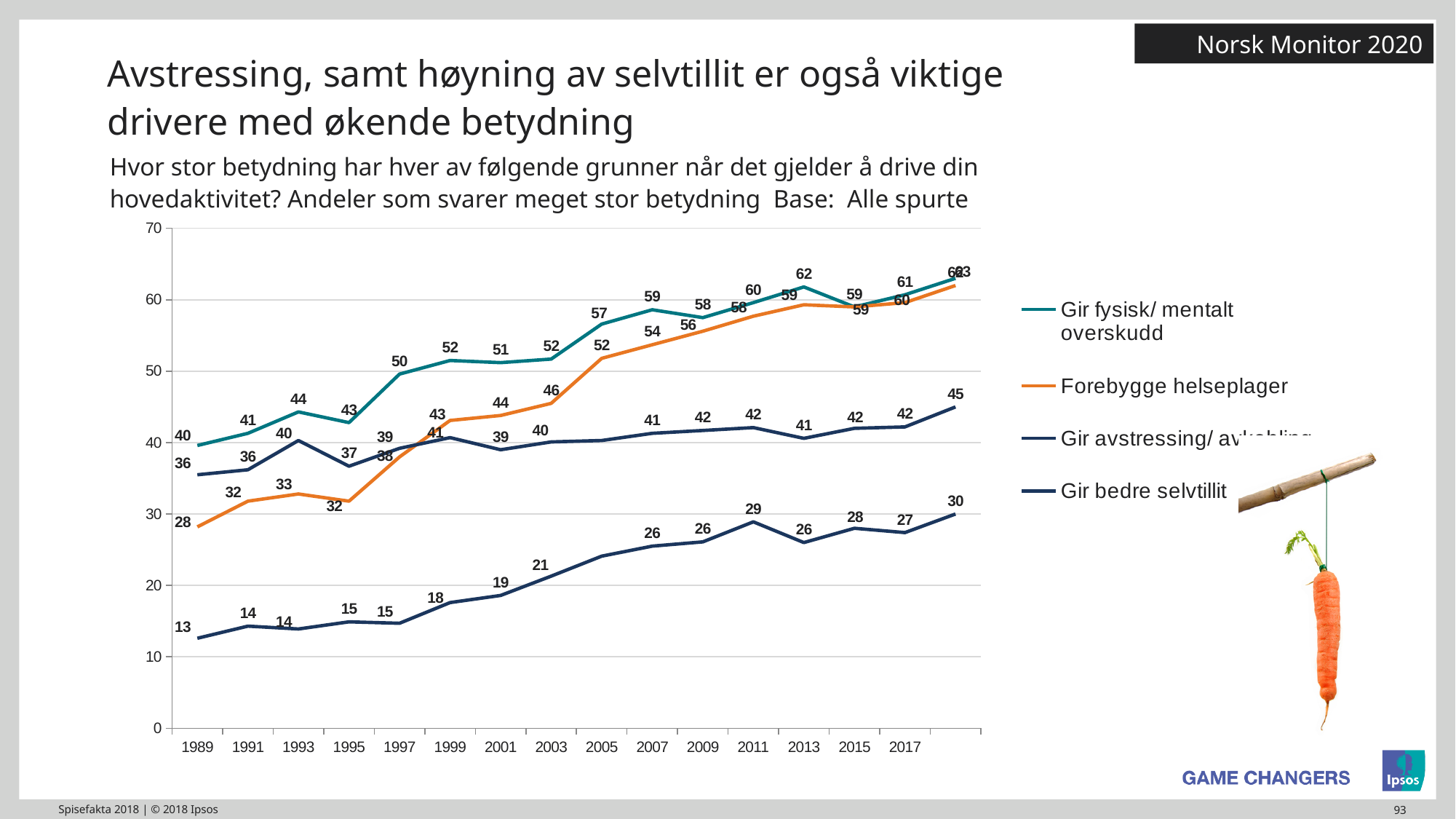
In 2011, which is larger: 'Gir fysisk/ mentalt overskudd' or 'Forebygge helseplager'? Gir fysisk/ mentalt overskudd What is the value for 'Gir fysisk/ mentalt overskudd' in 2013? 62 What is the value for 'Gir bedre selvtillit' in 2011? 29 What is the value for 'Forebygge helseplager' in 2013? 59 Which series has the lowest value in 2017? Gir bedre selvtillit Which series has the highest value in 1989? Gir fysisk/ mentalt overskudd How many series does the legend list? 4 What kind of chart is shown on the slide? line chart By how much did 'Forebygge helseplager' increase from 1989 to 2017? 32 What is the value for 'Gir bedre selvtillit' in 1989? 13 Does the 'Gir bedre selvtillit' line generally rise or fall from 1989 to the last point? rise Is the value for 'Gir bedre selvtillit' in 2005 greater or less than 30? less